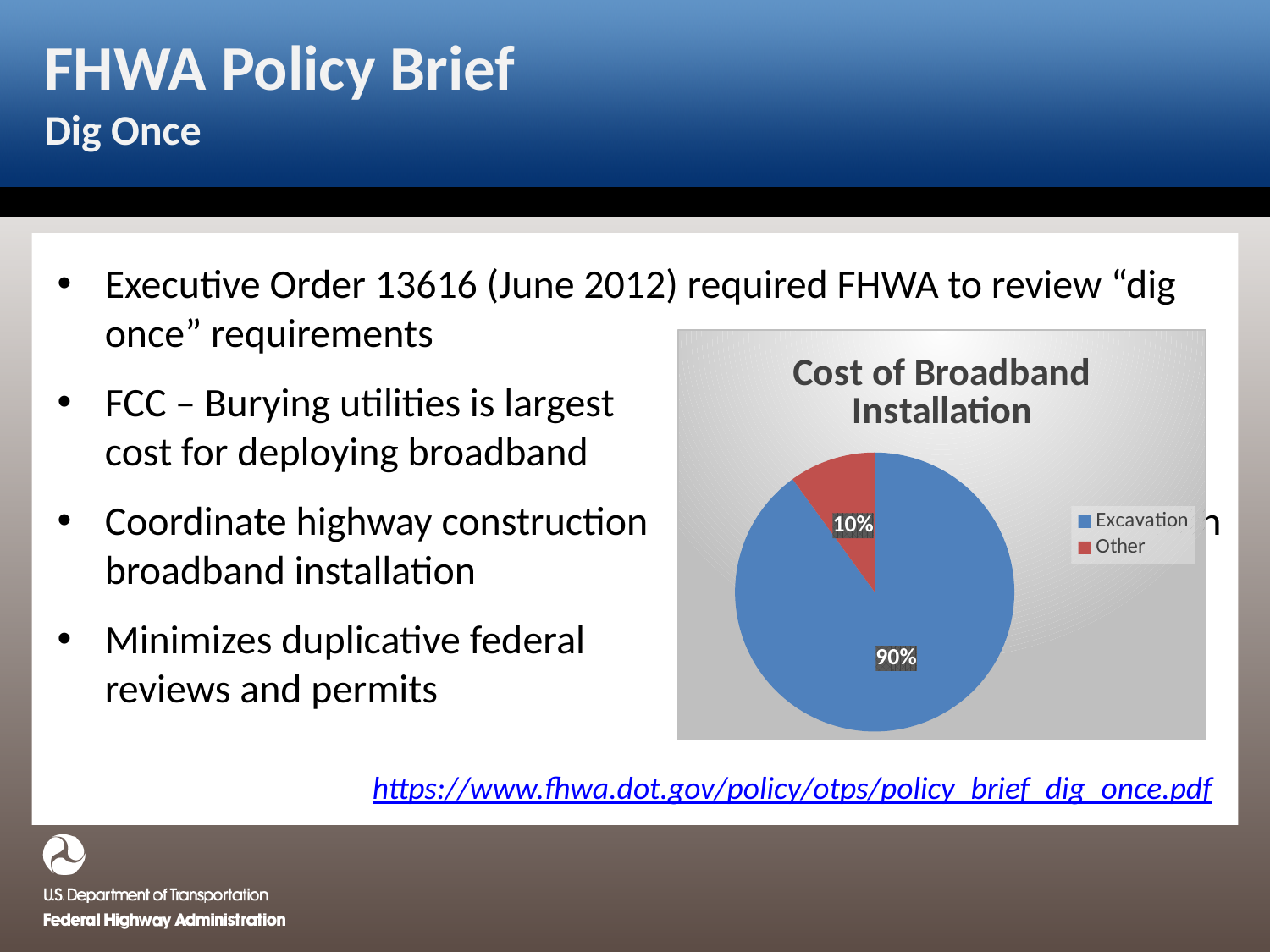
Which slice of the pie is the largest? Excavation Which slice of the pie is the smallest? Other What is the title of the chart? Cost of Broadband Installation Which is larger, the Excavation slice or the Other slice? Excavation How many slices does the pie chart have? 2 What kind of chart is shown on the slide? pie chart How many entries does the legend list? 2 What share of the pie does Excavation represent? 90% What share of the pie does Other represent? 10% What is the difference in percentage points between the Excavation slice and the Other slice? 80 percentage points What colour is the Excavation slice in the pie chart? blue